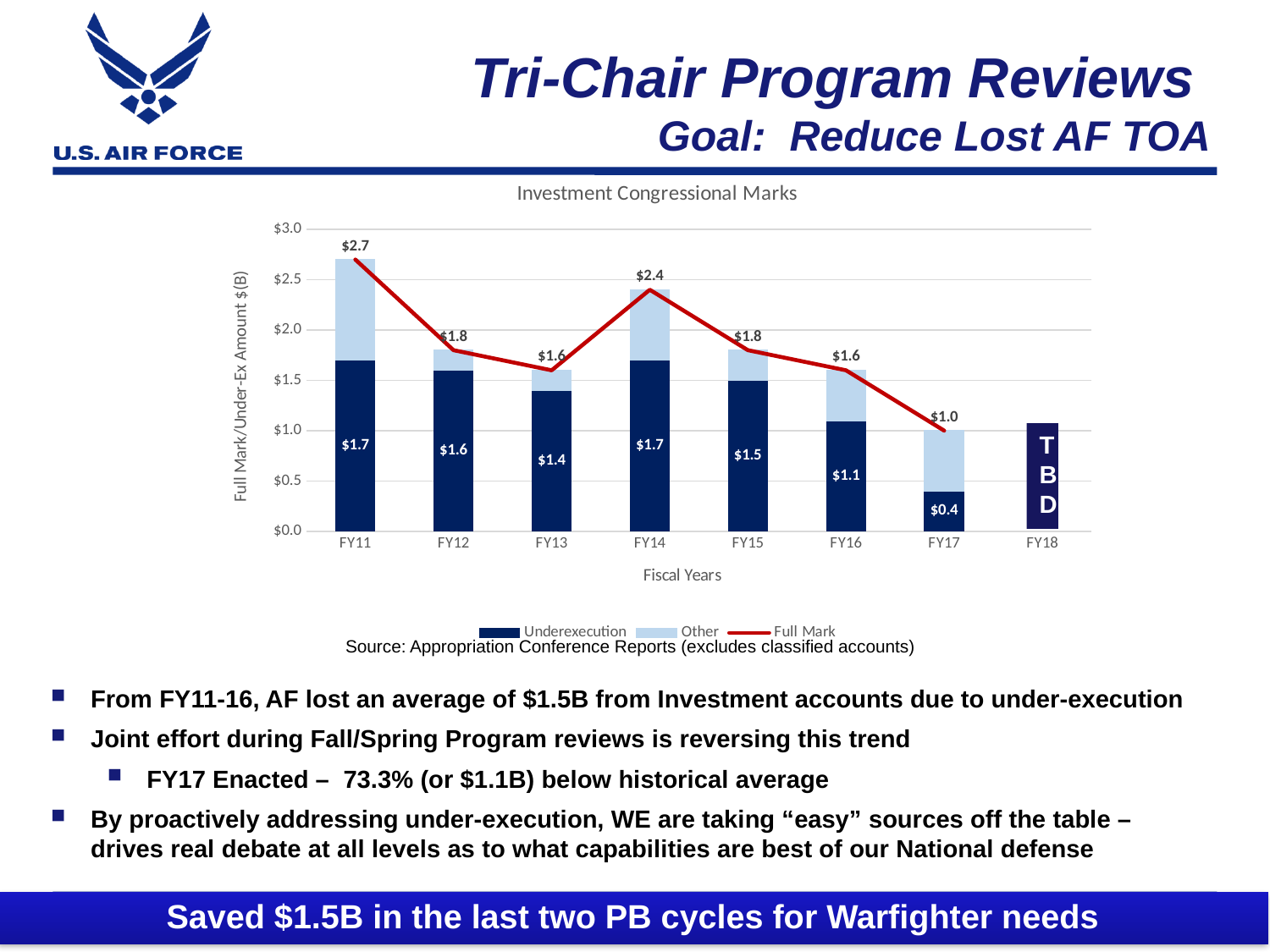
How many series does the legend list? 3 What is the difference between the Full Mark values for FY11 and FY12? $0.9 Among the fiscal years with a printed Underexecution value, which has the lowest? FY17 What is the Underexecution value for FY17? $0.4 How many fiscal years are shown on the x axis? 8 What is the Underexecution value for FY13? $1.4 What is the Full Mark value for FY14? $2.4 Does the Full Mark line rise or fall from FY14 to FY17? fall Which fiscal year has the highest Full Mark value? FY11 What is the difference between the Underexecution values for FY16 and FY17? $0.7 Which is larger, the Full Mark value for FY14 or for FY15? FY14 What label is shown on the FY18 bar instead of a value? TBD